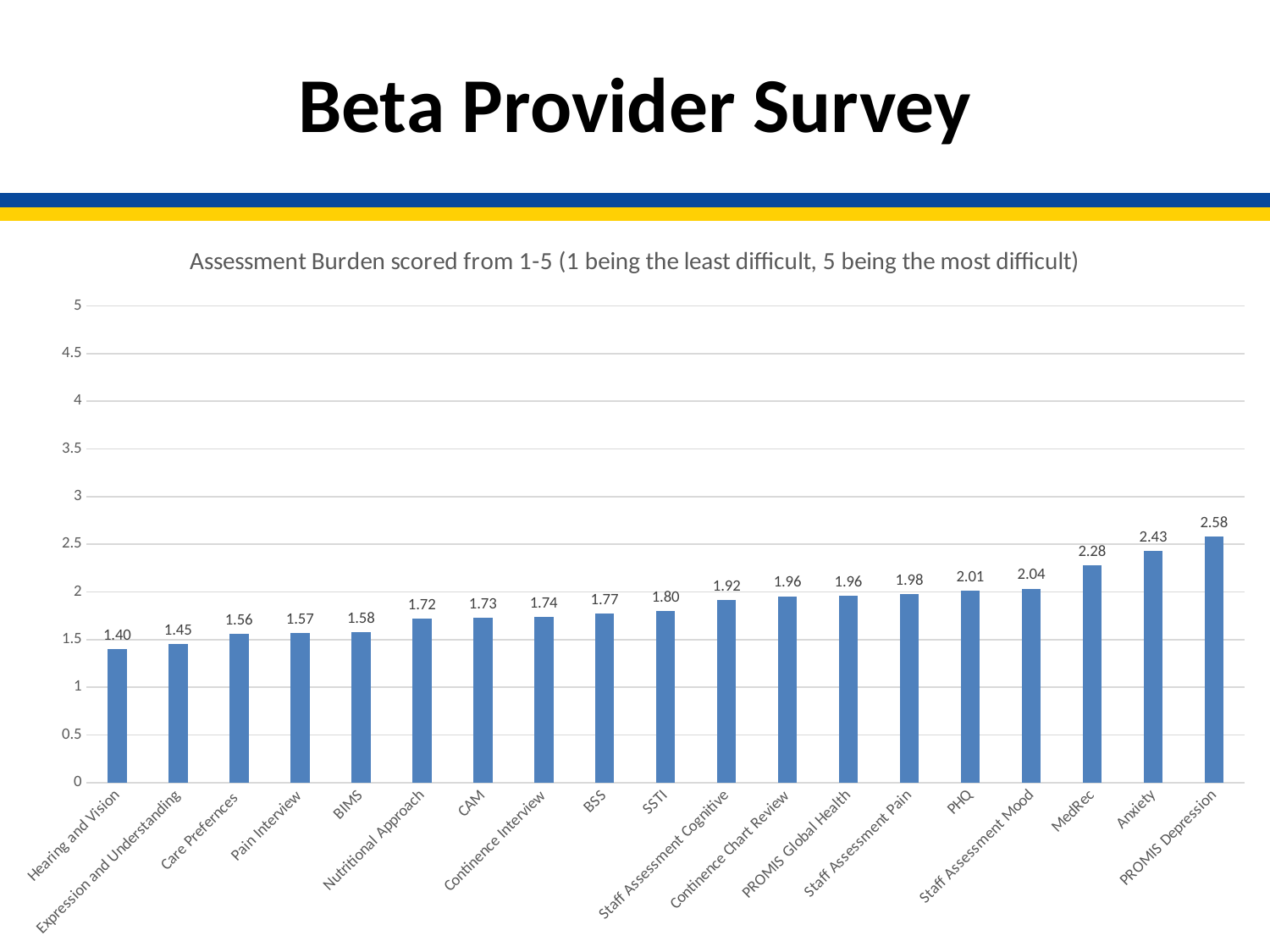
What is the assessment burden score for BIMS? 1.58 Which assessment has the lowest burden score? Hearing and Vision How many assessments are shown on the chart? 19 What is the difference between the scores for PROMIS Depression and Hearing and Vision? 1.18 Which has a higher burden score, Staff Assessment Mood or SSTI? Staff Assessment Mood Is the value for Care Preferences greater or less than 2? less What kind of chart is shown on the slide? Bar chart Do the scores rise or fall from left to right across the chart? Rise Which assessment has the highest burden score? PROMIS Depression What is the difference between the scores for Anxiety and PHQ? 0.42 What is the assessment burden score for MedRec? 2.28 What is the assessment burden score for Staff Assessment Cognitive? 1.92